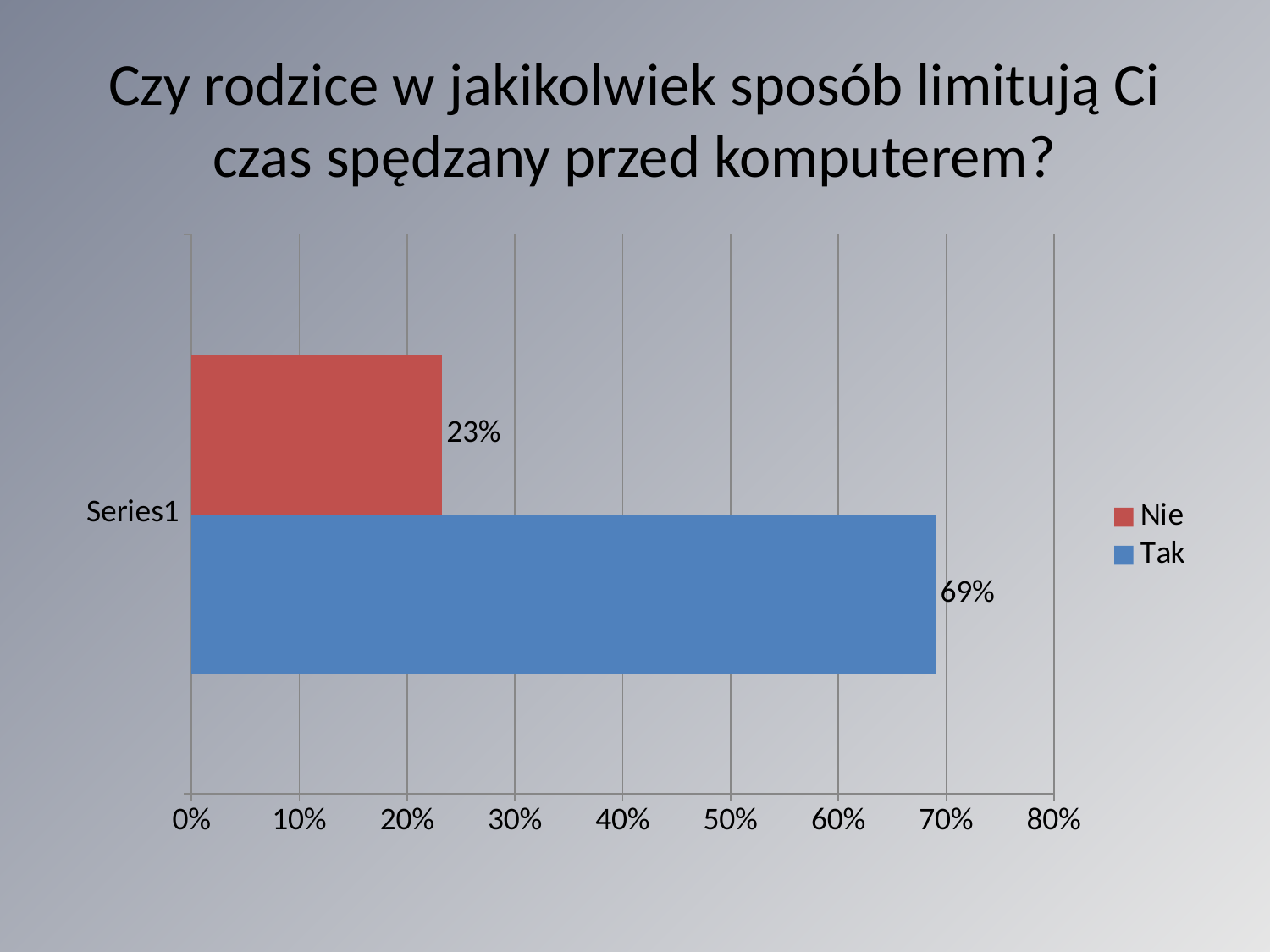
Is the value for Tak greater or less than 60%? greater What colour is the bar for Nie? red Which is larger, the value for Tak or the value for Nie? Tak How many series does the legend list? 2 What kind of chart is shown on the slide? bar chart What is the title of the chart? Czy rodzice w jakikolwiek sposób limitują Ci czas spędzany przed komputerem? What is the value for Tak? 69% Is the value for Nie greater or less than 30%? less Which series has the highest value? Tak Which series has the lowest value? Nie What is the difference between the values for Tak and Nie? 46% What is the value for Nie? 23%